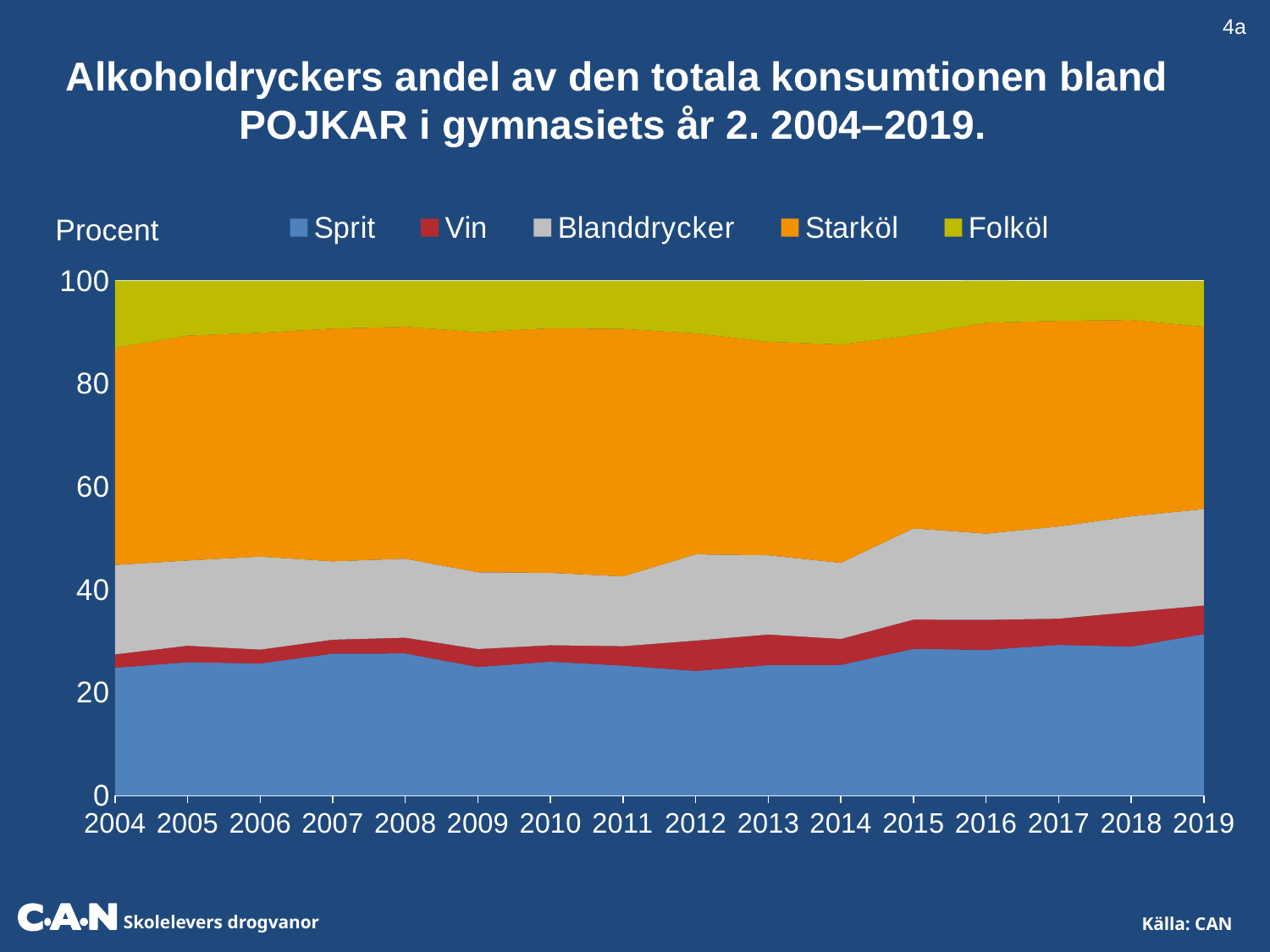
Is the share for Sprit in 2019 greater or less than 20? greater Which colour represents Starköl in the legend? Orange What label is shown on the y axis? Procent How many series does the legend list? 5 What kind of chart is shown on the slide? Stacked area chart Does the share for Sprit rise or fall from 2004 to 2019? rise How many years are shown along the x axis? 16 What is the first year shown on the x axis? 2004 What is the last year shown on the x axis? 2019 Which series has the largest share in 2004? Starköl Is the share for Sprit in 2004 greater or less than 40? less Which series has the smallest share in 2004? Vin